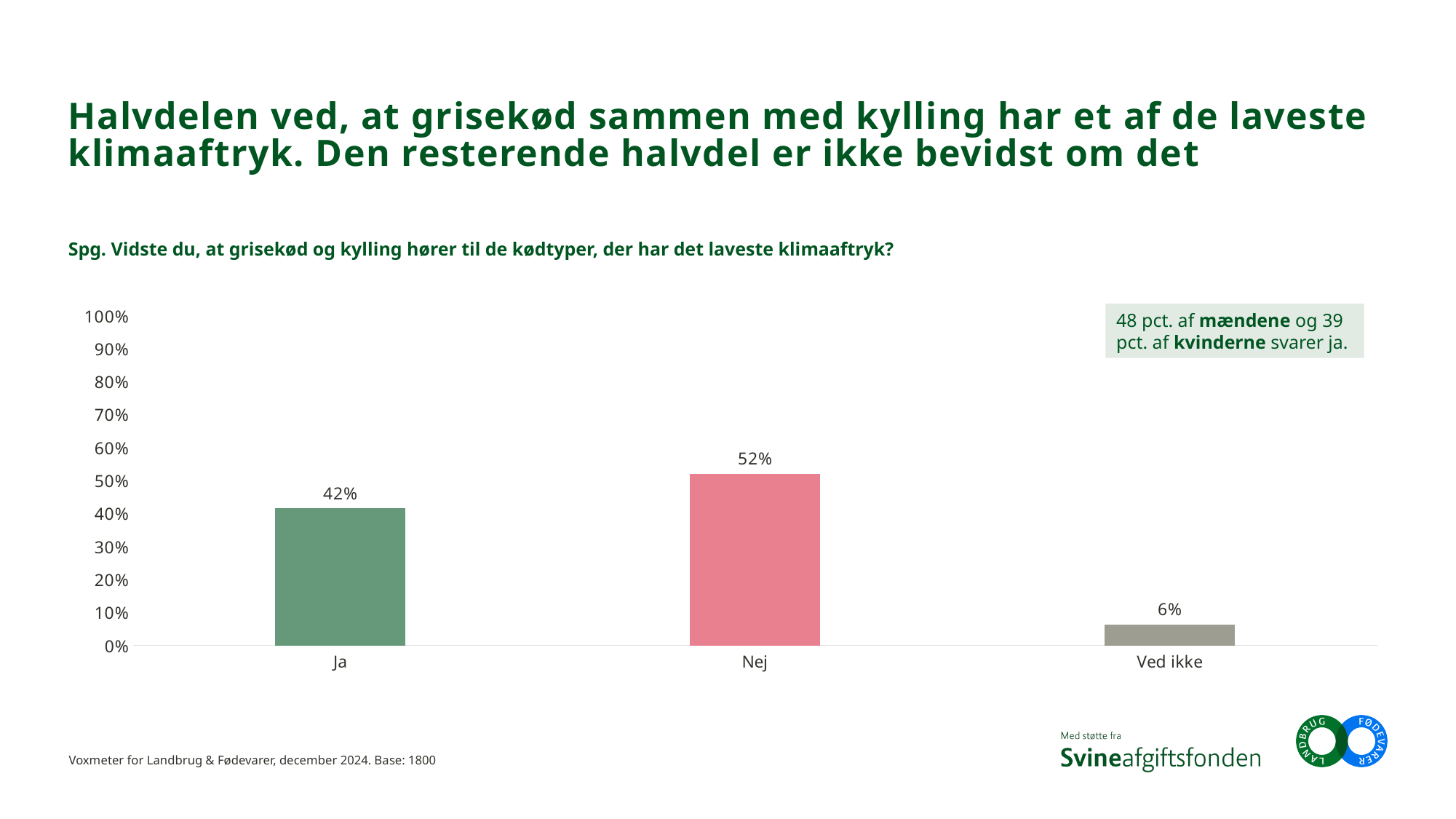
Which is larger, the value for "Ja" or the value for "Nej"? Nej How many categories are shown on the x axis? 3 What is the difference between the values for "Nej" and "Ja"? 10% Is the value for "Ja" greater or less than 50%? less What is the value for "Ved ikke"? 6% Which category has the highest value? Nej What colour is the bar for "Nej"? pink/red Which category has the lowest value? Ved ikke What is the value for "Ja"? 42% What is the highest value shown on the y axis? 100% What kind of chart is shown on the slide? bar chart What is the value for "Nej"? 52%